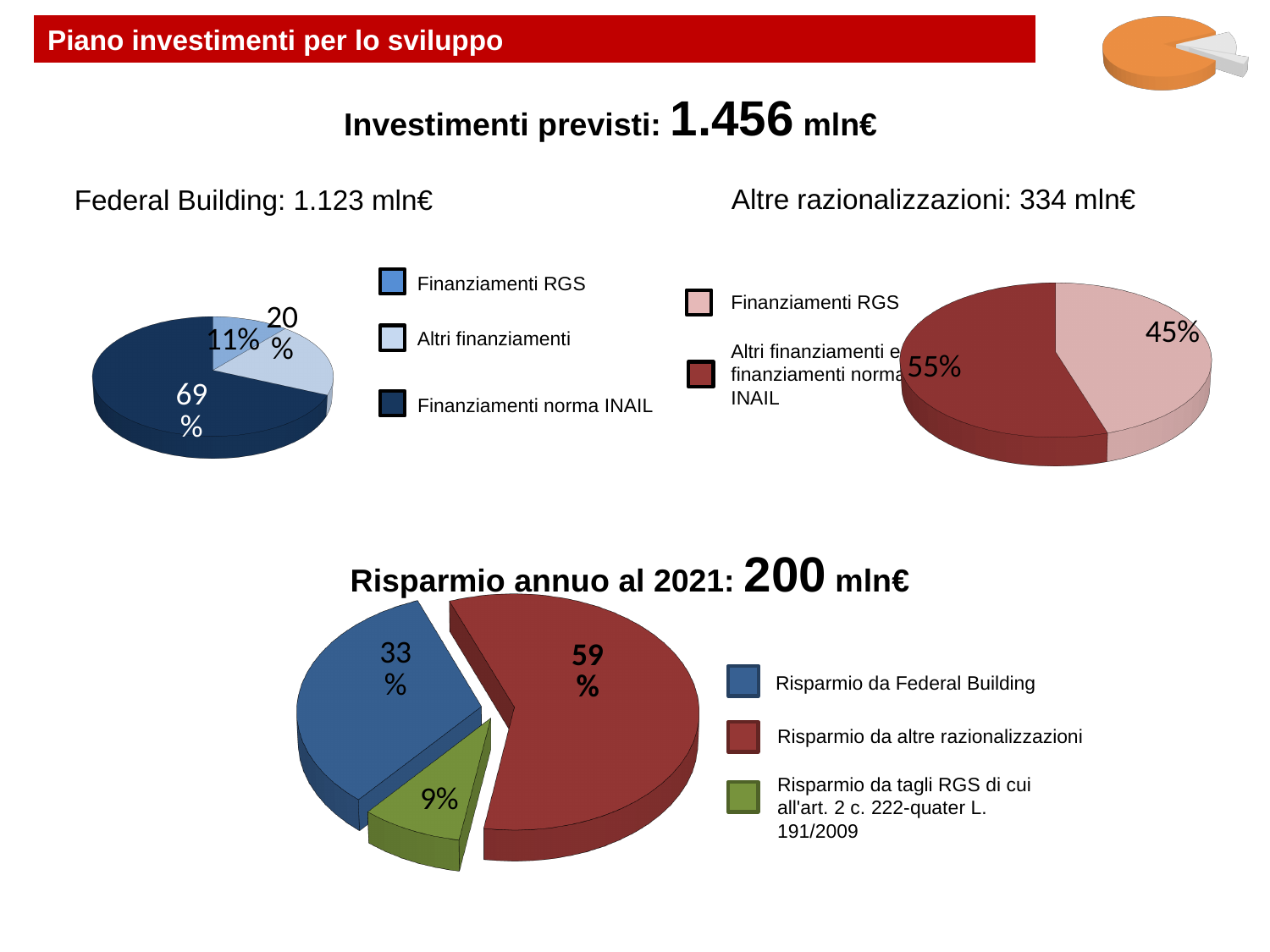
In the Federal Building pie chart, which category has the smallest slice? Finanziamenti RGS What type of chart is used for Risparmio annuo al 2021? Pie chart In the Risparmio annuo al 2021 pie chart, which category has the smallest slice? Risparmio da tagli RGS di cui all'art. 2 c. 222-quater L. 191/2009 In the Federal Building pie chart, what share is Finanziamenti norma INAIL? 69% In the Altre razionalizzazioni pie chart, what share is Finanziamenti RGS? 45% In the Risparmio annuo al 2021 pie chart, what share is Risparmio da altre razionalizzazioni? 59% In the Altre razionalizzazioni pie chart, what is the difference between the two slices? 10% In the Risparmio annuo al 2021 pie chart, which is larger: Risparmio da Federal Building or Risparmio da altre razionalizzazioni? Risparmio da altre razionalizzazioni In the Federal Building pie chart, which category has the largest slice? Finanziamenti norma INAIL How many slices does the Altre razionalizzazioni pie chart have? 2